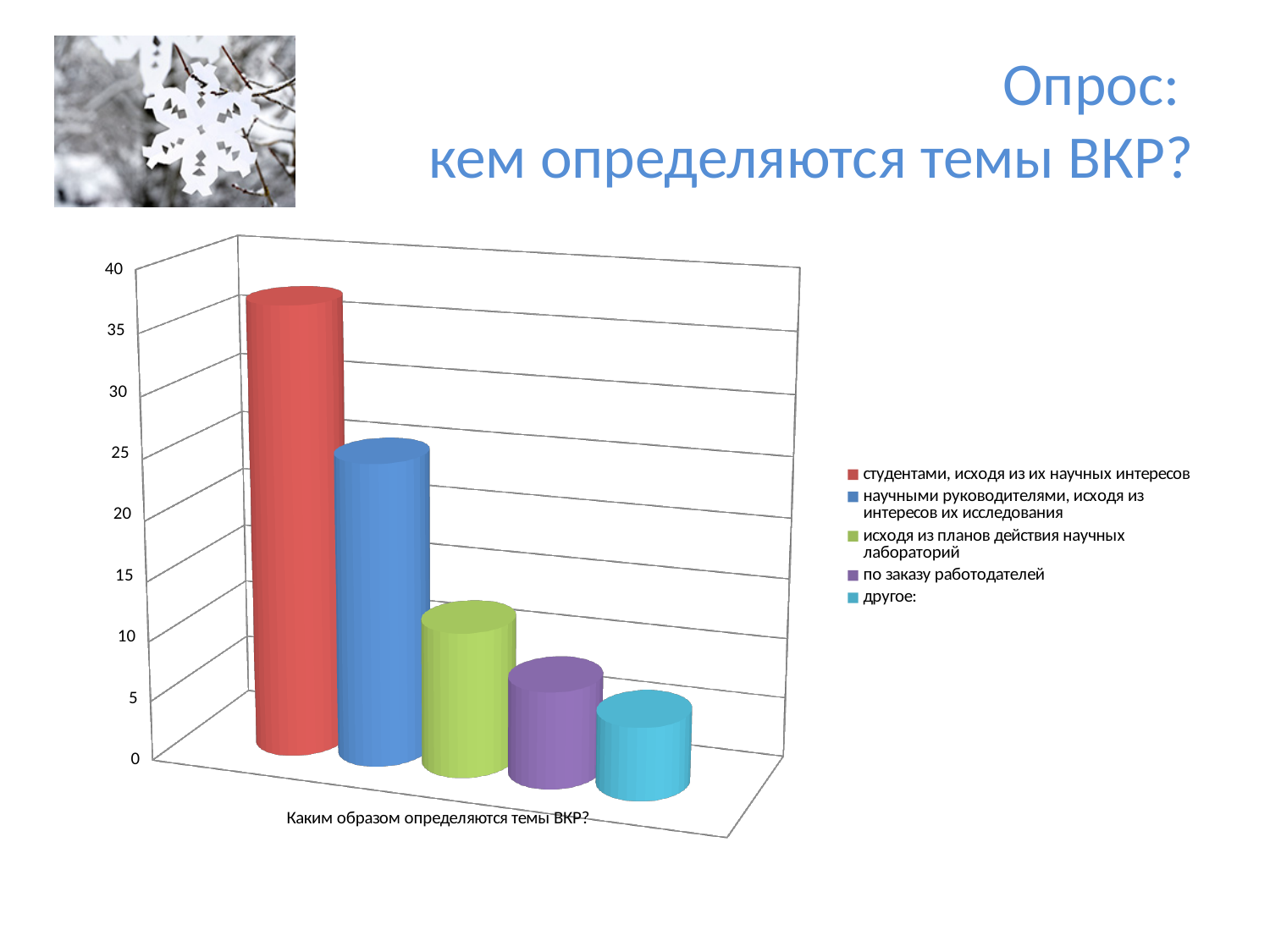
What is the category label shown on the x axis of the chart? Каким образом определяются темы ВКР? Which is larger: the value for 'студентами, исходя из их научных интересов' or for 'научными руководителями, исходя из интересов их исследования'? студентами, исходя из их научных интересов Is the value for 'другое:' greater or less than 10? less Which series has the highest value? студентами, исходя из их научных интересов Which series has the lowest value? другое: How many categories are shown on the x axis? 1 How many series does the legend list? 5 Is the value for 'студентами, исходя из их научных интересов' greater or less than 30? greater Is the value for 'научными руководителями, исходя из интересов их исследования' greater or less than 15? greater Which is larger: the value for 'исходя из планов действия научных лабораторий' or for 'по заказу работодателей'? исходя из планов действия научных лабораторий What kind of chart is shown on the slide? bar chart